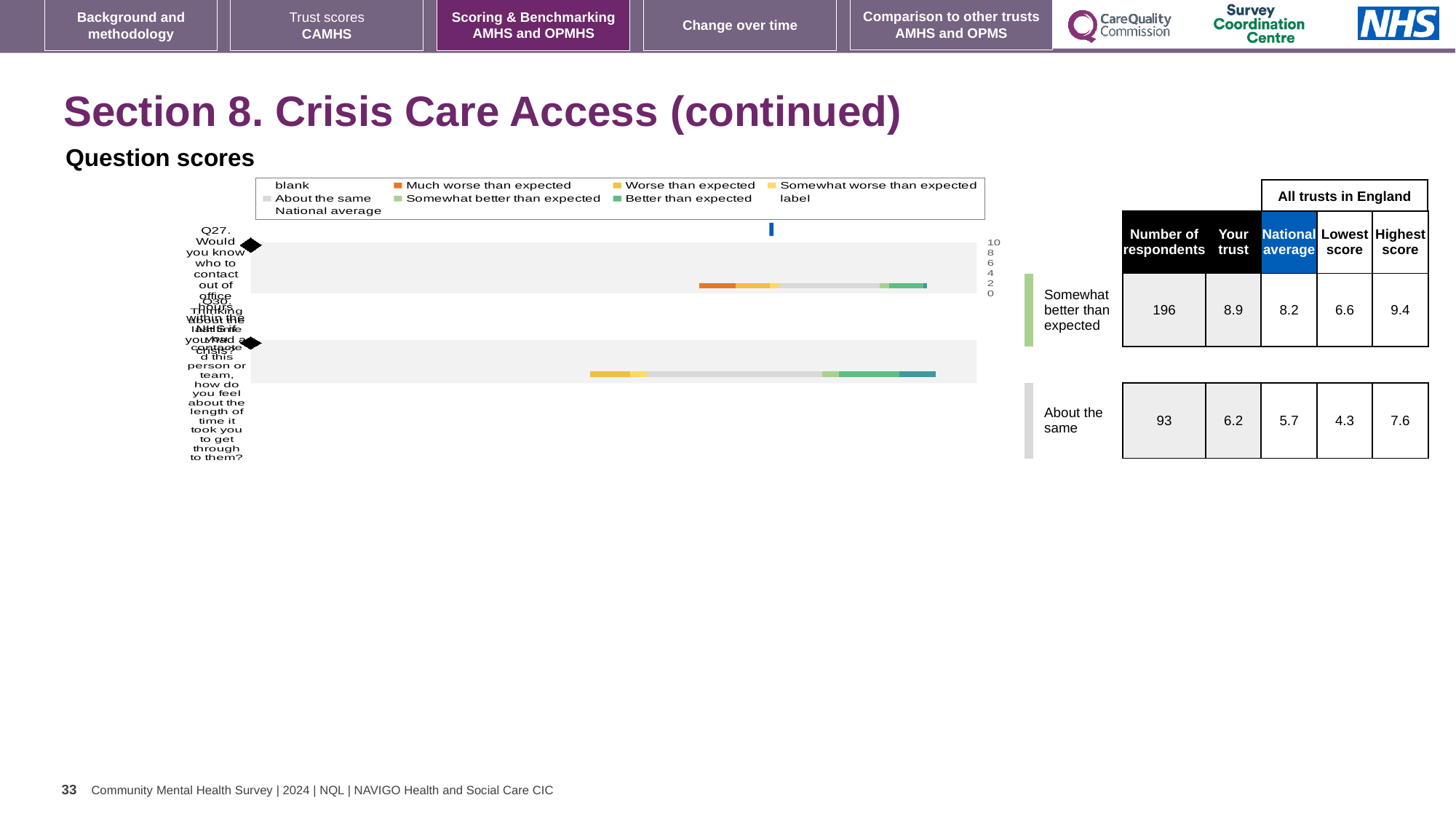
By how much does the trust's score for Q27 exceed the national average for Q27? 0.7 What is the national average score for Q30 (how do you feel about the length of time it took you to get through)? 5.7 What is the difference between the highest and lowest scores for Q30? 3.3 What is the lowest score among all trusts in England for Q30? 4.3 What benchmark category is shown for Q27? Somewhat better than expected What is the highest score among all trusts in England for Q27? 9.4 What kind of chart is used to show the question scores on this slide? bar chart How many respondents answered Q30? 93 What is the 'Your trust' score for Q27 (Would you know who to contact out of office hours)? 8.9 Which question has the higher 'Your trust' score, Q27 or Q30? Q27 Which question had more respondents, Q27 or Q30? Q27 How many questions are plotted in the question scores chart? 2